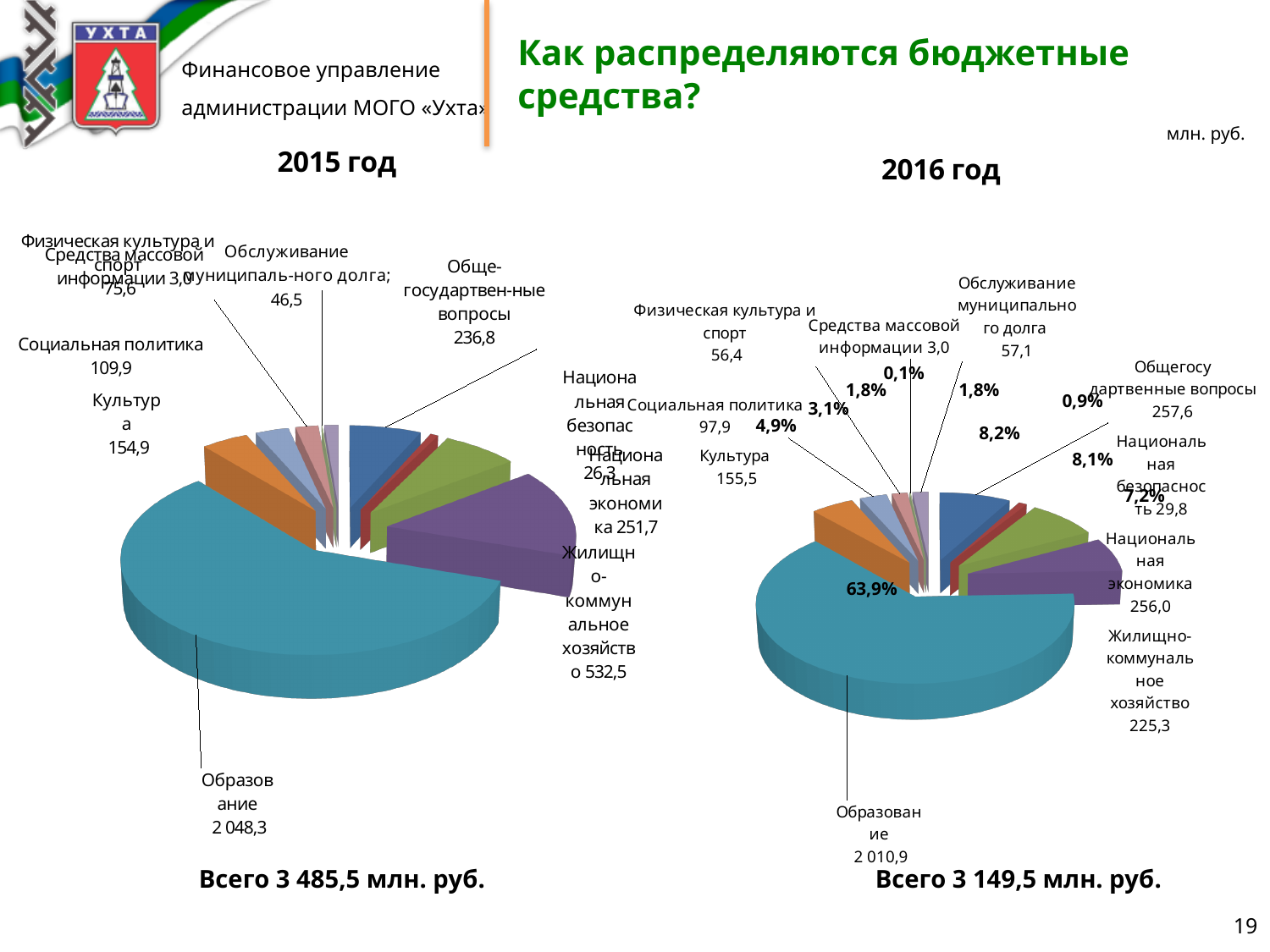
On the 2015 год chart, what is the difference between Жилищно-коммунальное хозяйство (532,5) and Национальная экономика (251,7)? 280,8 On the 2015 год chart, which category has the largest value? Образование On the 2016 год chart, what share of the pie does Образование represent? 63,9% On the 2016 год chart, what is the value for Жилищно-коммунальное хозяйство? 225,3 What is the total shown below the 2016 год chart? Всего 3 149,5 млн. руб. On the 2016 год chart, which category has the smallest value? Средства массовой информации What type of chart is used for the 2016 год data? Pie chart What unit is indicated in the top right of the slide for the chart values? млн. руб. On the 2016 год chart, what is the value for Общегосударственные вопросы? 257,6 How many categories are shown on the 2015 год chart? 10 On the 2016 год chart, which is larger: Культура or Социальная политика? Культура On the 2015 год chart, what is the value for Образование? 2 048,3